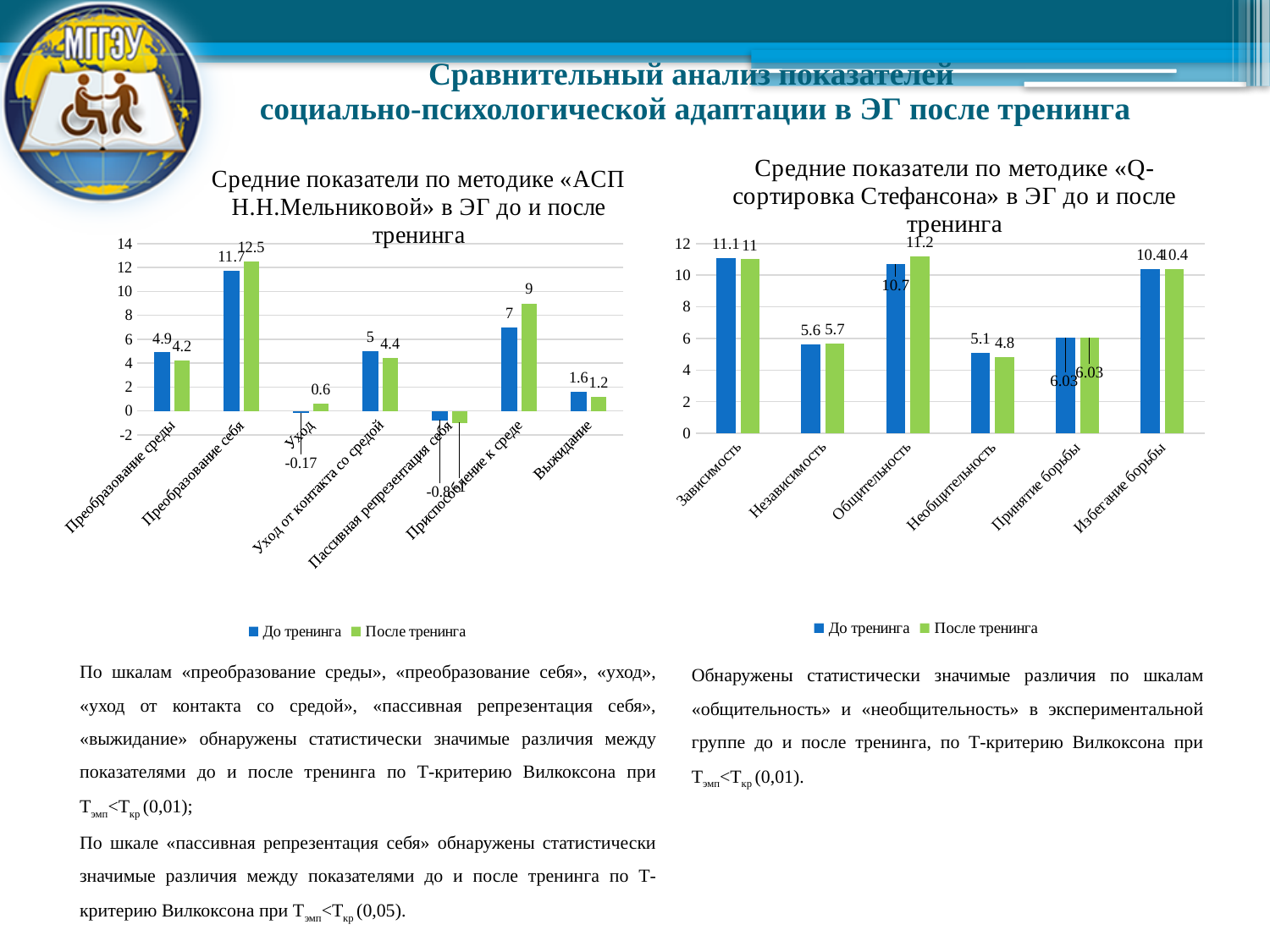
What type of chart is the right chart (Q-сортировка Стефансона)? Bar chart In the left chart (АСП Н.Н.Мельниковой), how many categories are shown on the x axis? 7 In the left chart (АСП Н.Н.Мельниковой), what is the difference between the before and after training values for «Приспособление к среде»? 2 In the right chart (Q-сортировка Стефансона), which category has the lowest value after the training (После тренинга)? Необщительность In the left chart (АСП Н.Н.Мельниковой), what is the value for «Преобразование себя» after the training (После тренинга)? 12.5 In the right chart (Q-сортировка Стефансона), what is the value for «Общительность» after the training (После тренинга)? 11.2 In the left chart (АСП Н.Н.Мельниковой), is the value for «Выжидание» before the training greater or less than 2? less In the left chart (АСП Н.Н.Мельниковой), which category has the highest value after the training (После тренинга)? Преобразование себя In the right chart (Q-сортировка Стефансона), what is the value for «Принятие борьбы» before the training (До тренинга)? 6.03 How many series does the legend of the right chart (Q-сортировка Стефансона) list? 2 In the left chart (АСП Н.Н.Мельниковой), what is the value for «Уход» before the training (До тренинга)? -0.17 In the right chart (Q-сортировка Стефансона), which is larger for «Необщительность»: the value before the training or after the training? Before the training (До тренинга)